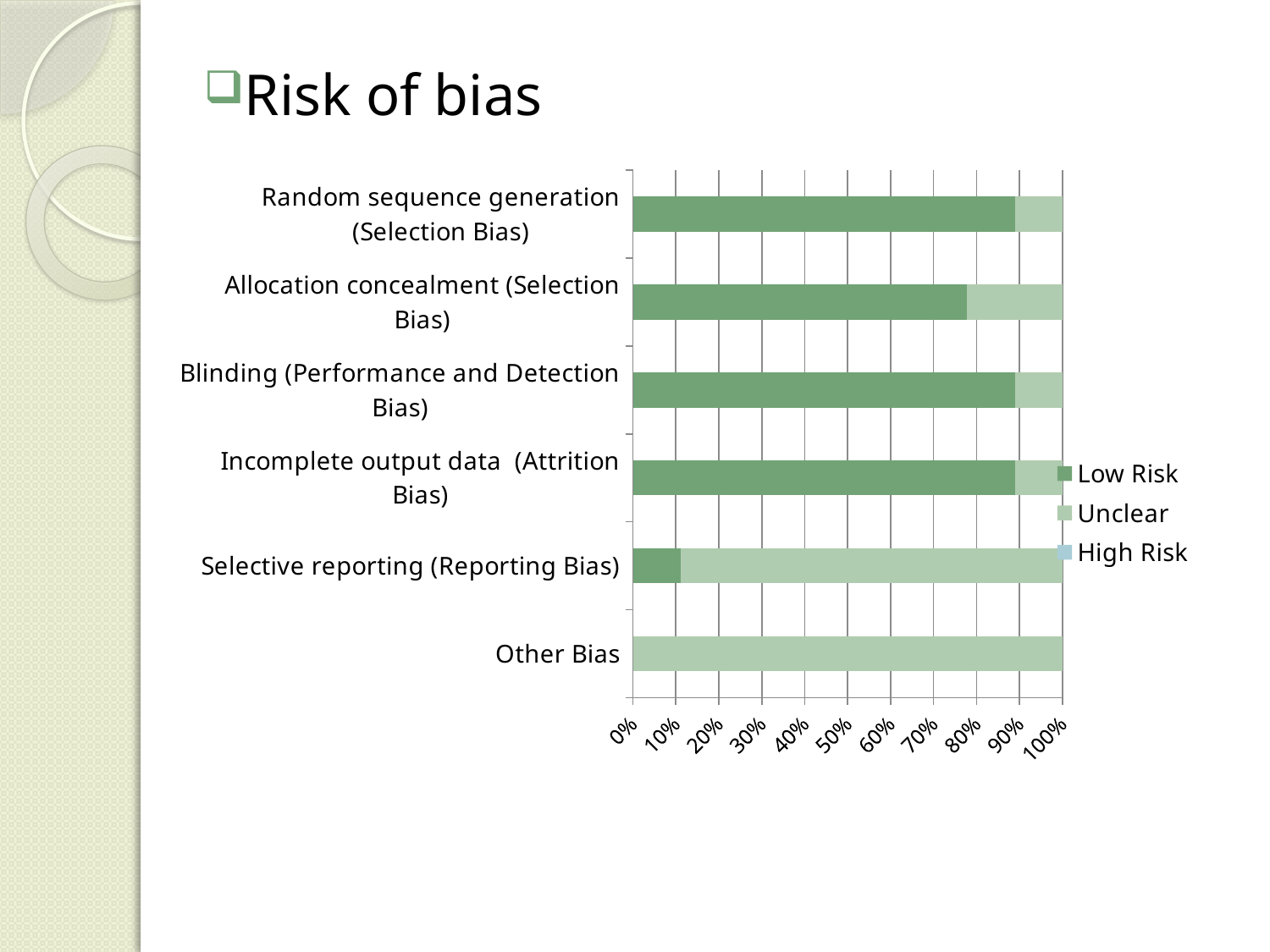
How many series does the legend list? 3 Is the Low Risk value for Allocation concealment (Selection Bias) greater or less than 70%? greater Which has a larger Low Risk value: Random sequence generation (Selection Bias) or Allocation concealment (Selection Bias)? Random sequence generation (Selection Bias) Which category has the largest Unclear share? Other Bias What kind of chart is shown on the slide? bar chart Which has a larger Unclear value: Selective reporting (Reporting Bias) or Blinding (Performance and Detection Bias)? Selective reporting (Reporting Bias) How many bias categories are plotted on the chart? 6 Is the Low Risk value for Random sequence generation (Selection Bias) greater or less than 80%? greater What is the Unclear value for Other Bias? 100% What are the three series named in the legend? Low Risk, Unclear, High Risk What is the title of the slide containing the chart? Risk of bias Is the Low Risk value for Selective reporting (Reporting Bias) greater or less than 20%? less